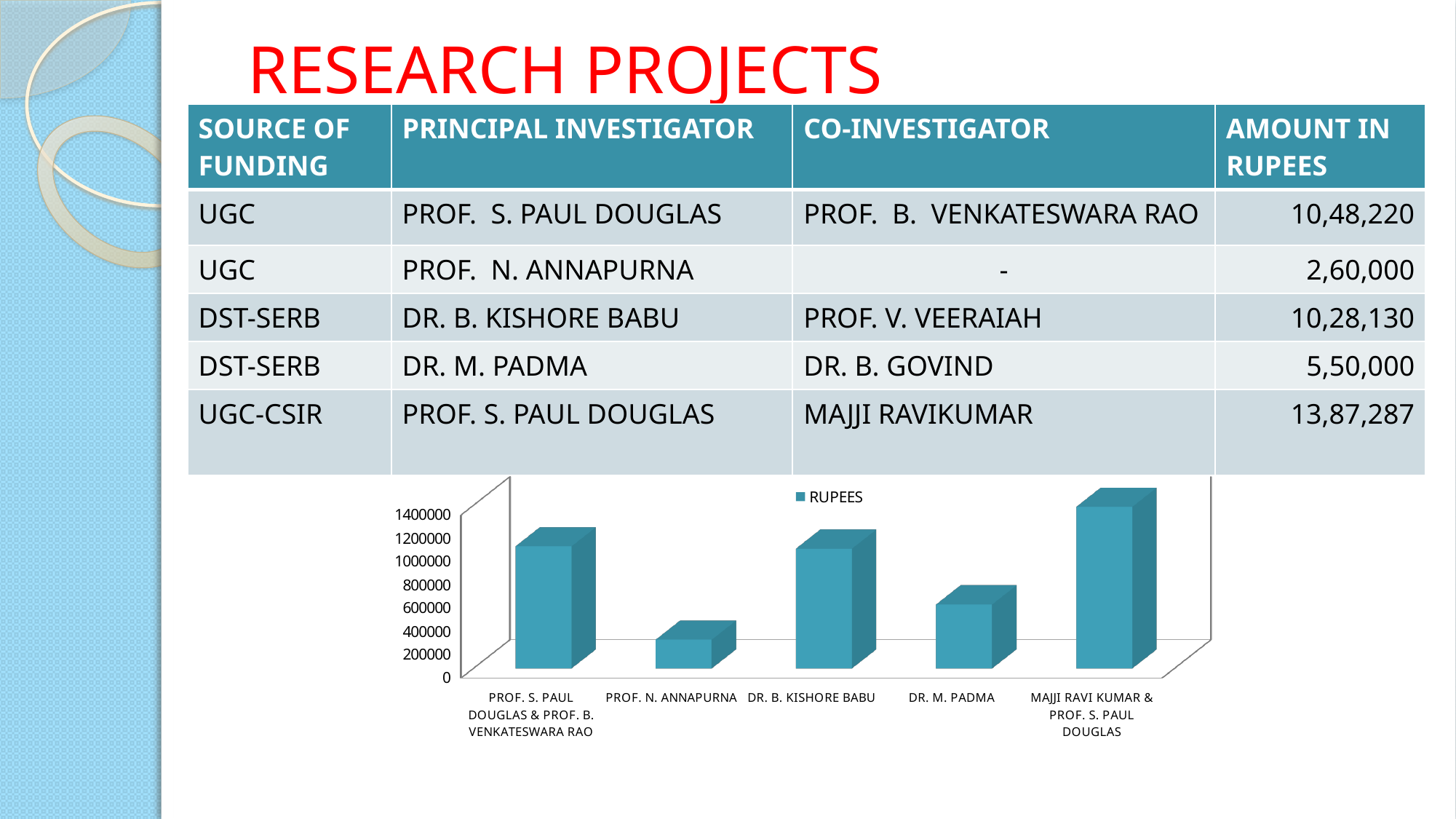
How many bars (categories) does the chart show? 5 How many series does the chart legend list? 1 What kind of chart is shown below the table on the slide? bar chart Is the value for DR. B. KISHORE BABU greater or less than 800000? greater Is the value for PROF. N. ANNAPURNA greater or less than 400000? less Which is larger in the chart, the value for DR. M. PADMA or the value for DR. B. KISHORE BABU? DR. B. KISHORE BABU Is the value for DR. M. PADMA greater or less than 800000? less Which category has the highest bar in the chart? MAJJI RAVI KUMAR & PROF. S. PAUL DOUGLAS What is the name of the series shown in the chart legend? RUPEES Which category has the lowest bar in the chart? PROF. N. ANNAPURNA